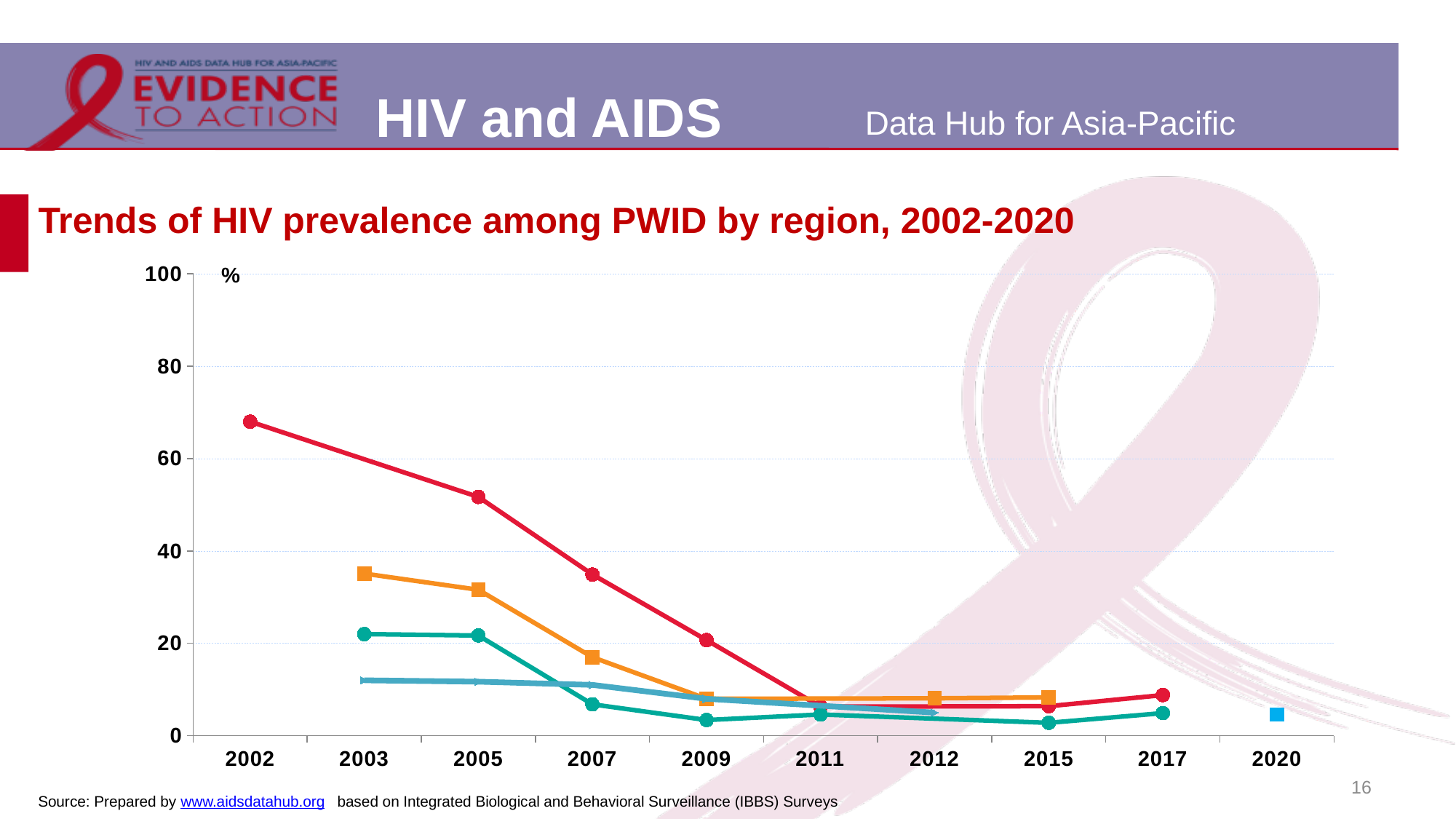
How many years are labelled along the x axis of the chart? 10 Does the red line generally rise or fall from 2002 to 2011? fall Is the value of the red line in 2007 greater or less than 40? less What kind of chart is shown on the slide? line chart What unit is shown on the y axis of the chart? % What is the title of the chart? Trends of HIV prevalence among PWID by region, 2002-2020 In 2005, which is larger: the value of the red line or the value of the orange line? the red line Is the value of the red line in 2005 greater or less than 60? less Is the value of the orange line in 2003 greater or less than 40? less In which year does the red line reach its highest value? 2002